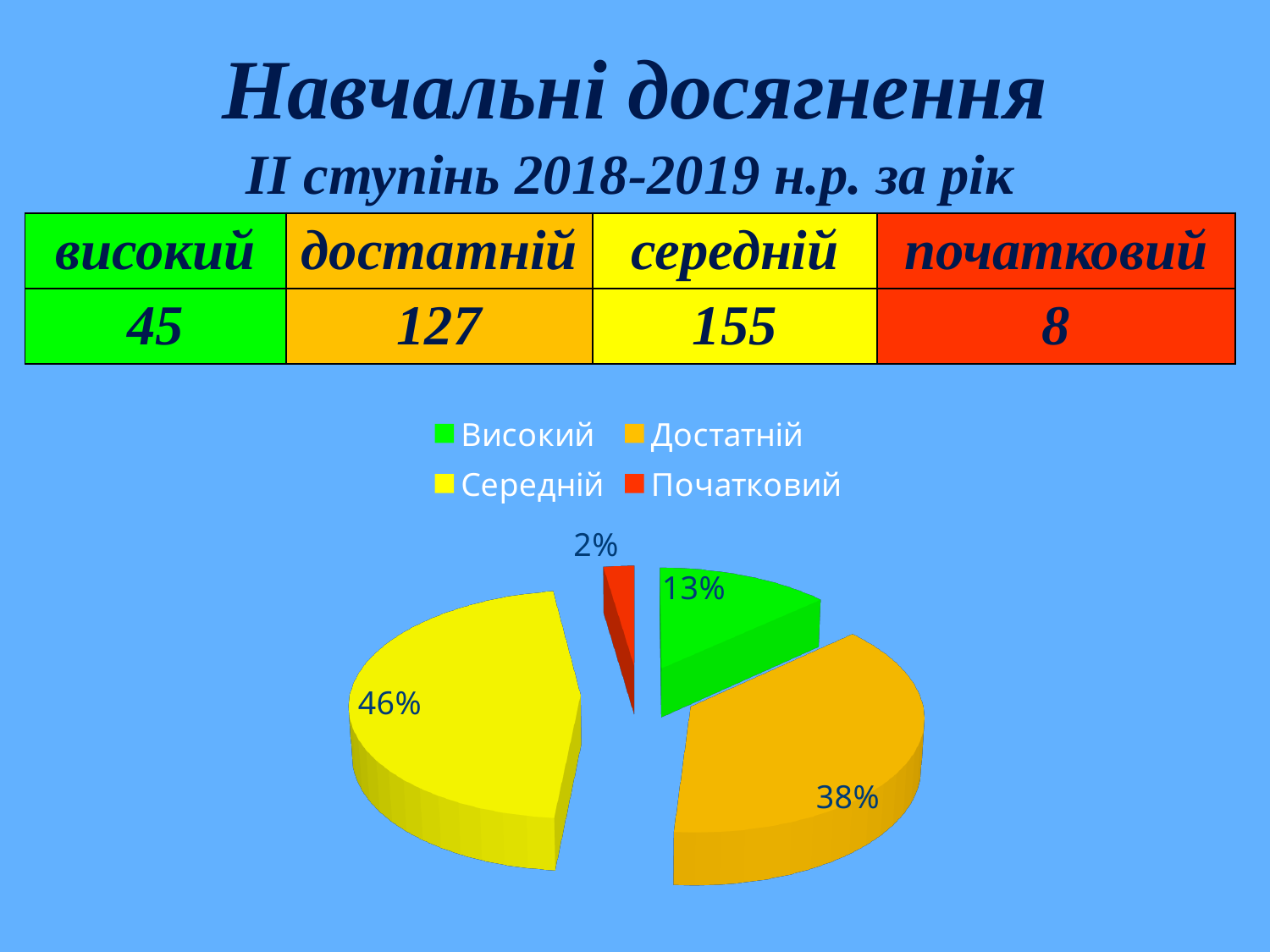
What share of the pie does the Початковий slice represent? 2% What share of the pie does the Середній slice represent? 46% What share of the pie does the Достатній slice represent? 38% What is the difference in percentage points between the Середній and Достатній slices? 8% How many slices does the pie chart have? 4 Which slice of the pie chart is the largest? Середній What kind of chart is shown on the slide? pie chart What colour is the Початковий slice in the pie chart? red Which is larger in the pie chart, the Достатній slice or the Високий slice? Достатній Which slice of the pie chart is the smallest? Початковий How many entries does the legend of the pie chart list? 4